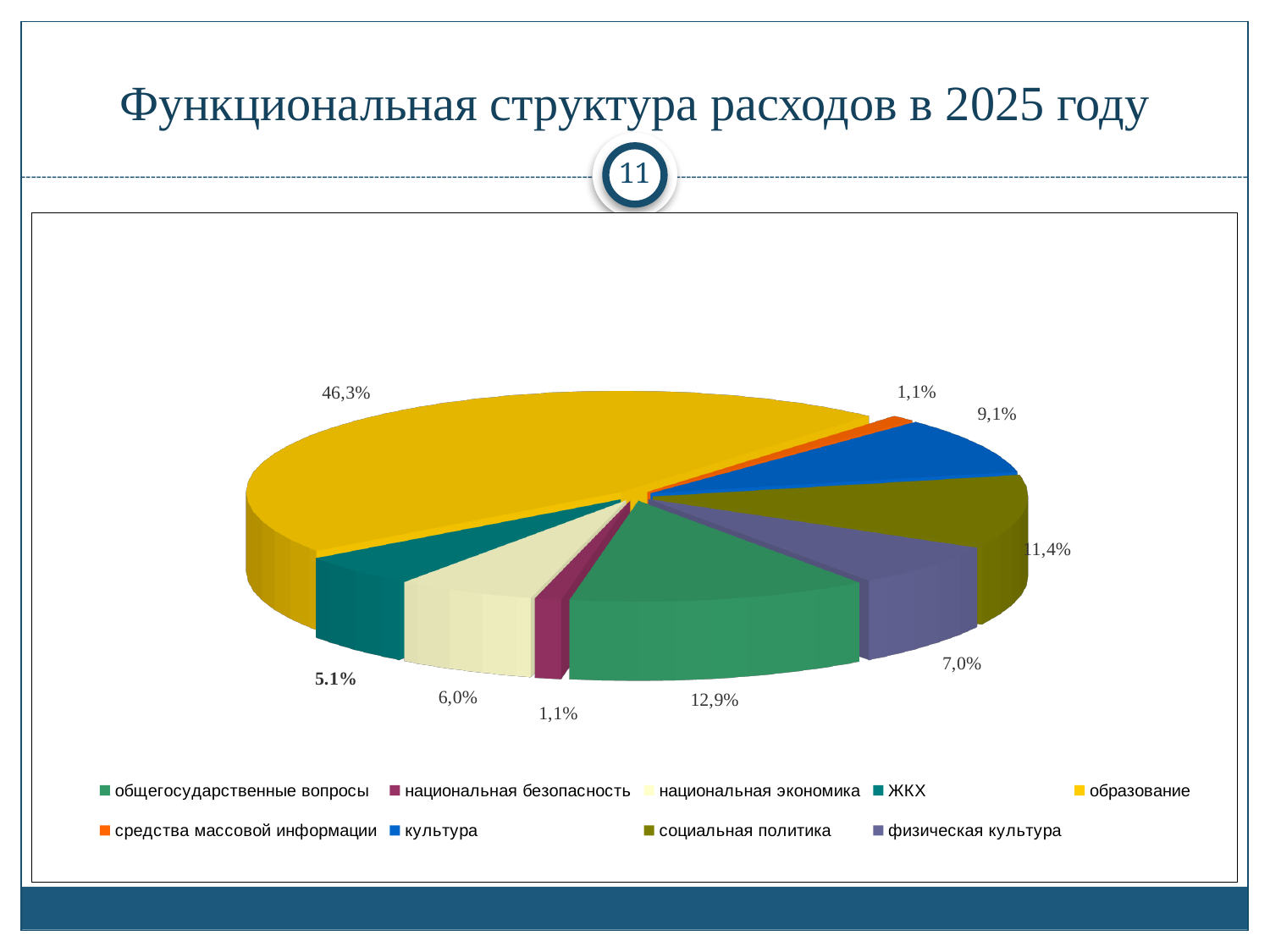
How many categories does the legend list? 9 Which category has the largest share of the pie? образование What is the title of the slide containing the chart? Функциональная структура расходов в 2025 году What is the difference between the shares for социальная политика and культура? 2,3% What is the value shown for социальная политика? 11,4% What is the value shown for физическая культура? 7,0% What is the value shown for ЖКХ? 5.1% What kind of chart is shown on the slide? pie chart Which is larger, the share for культура or the share for национальная экономика? культура What is the difference between the shares for образование and общегосударственные вопросы? 33,4% What is the value shown for общегосударственные вопросы? 12,9% What share of expenditures does образование account for? 46,3%